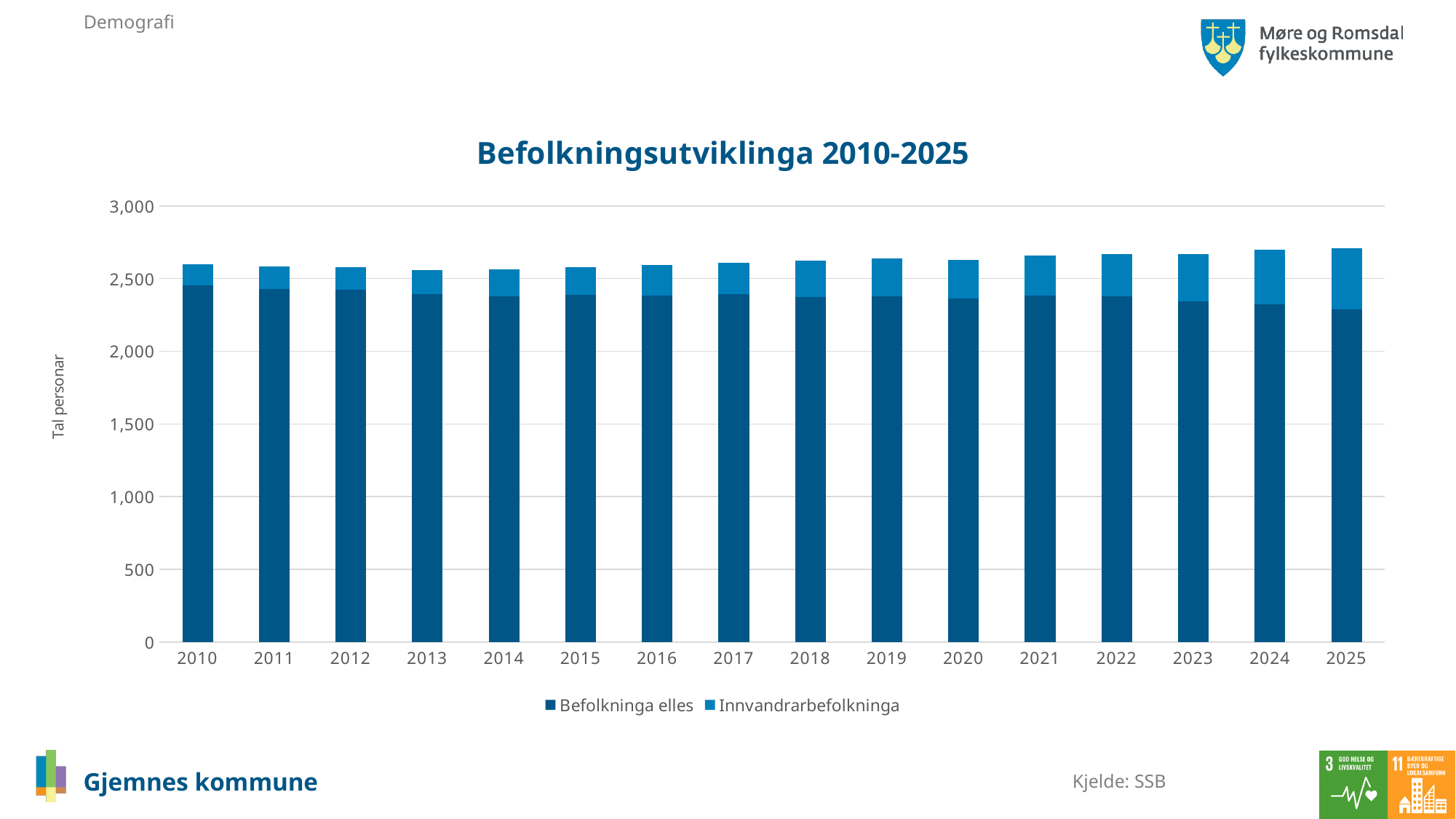
Which is larger, the Befolkninga elles value in 2010 or in 2025? 2010 Is the total population (full bar) for 2025 greater or less than 3,000? less How many years are shown on the x axis? 16 What is the label of the y axis? Tal personar Does the Innvandrarbefolkninga segment generally rise or fall from 2010 to 2025? rise In which year is the Innvandrarbefolkninga segment the largest? 2025 Is the value for Befolkninga elles in 2025 greater or less than 2,500? less What type of chart is shown on the slide? Stacked bar chart How many series does the legend list? 2 Is the total population (full bar) for 2010 greater or less than 2,500? greater In which year is the Befolkninga elles segment the smallest? 2025 What is the title of the chart? Befolkningsutviklinga 2010-2025